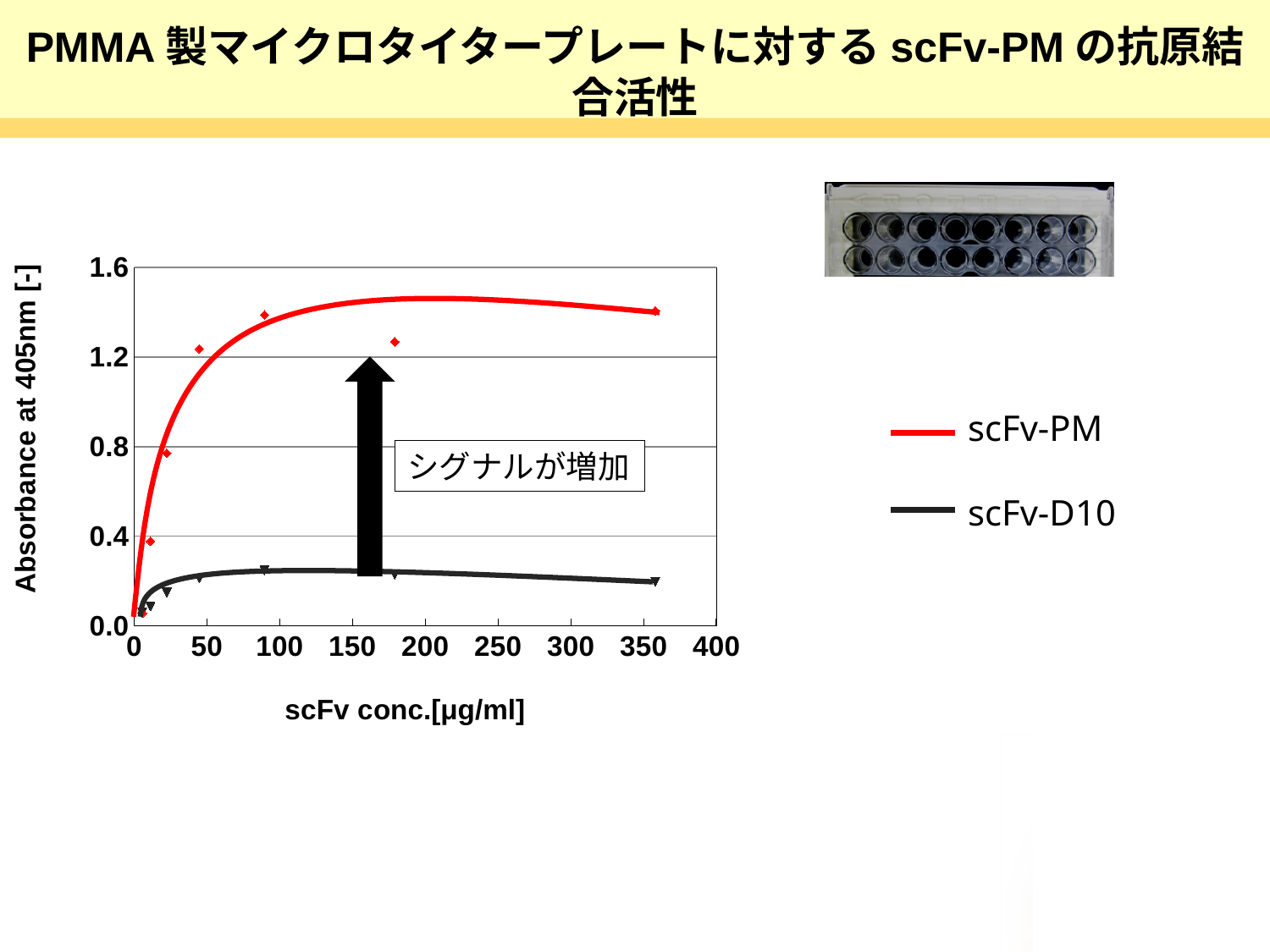
Is the value for scFv-PM at an scFv concentration of 100 µg/ml greater or less than 0.8? greater Is the value for scFv-D10 at an scFv concentration of 200 µg/ml greater or less than 0.4? less Which series reaches the highest absorbance on the chart? scFv-PM What kind of chart is shown on the slide? line chart Is the value for scFv-PM at an scFv concentration of 350 µg/ml greater or less than 1.2? greater At an scFv concentration of 200 µg/ml, which series has the higher absorbance, scFv-PM or scFv-D10? scFv-PM Does the scFv-PM curve rise or fall as the scFv concentration increases from 0 to 100 µg/ml? rise Which series is drawn in red? scFv-PM What is the label of the y axis? Absorbance at 405nm [-] How many series does the legend list? 2 What is the highest value shown on the y axis? 1.6